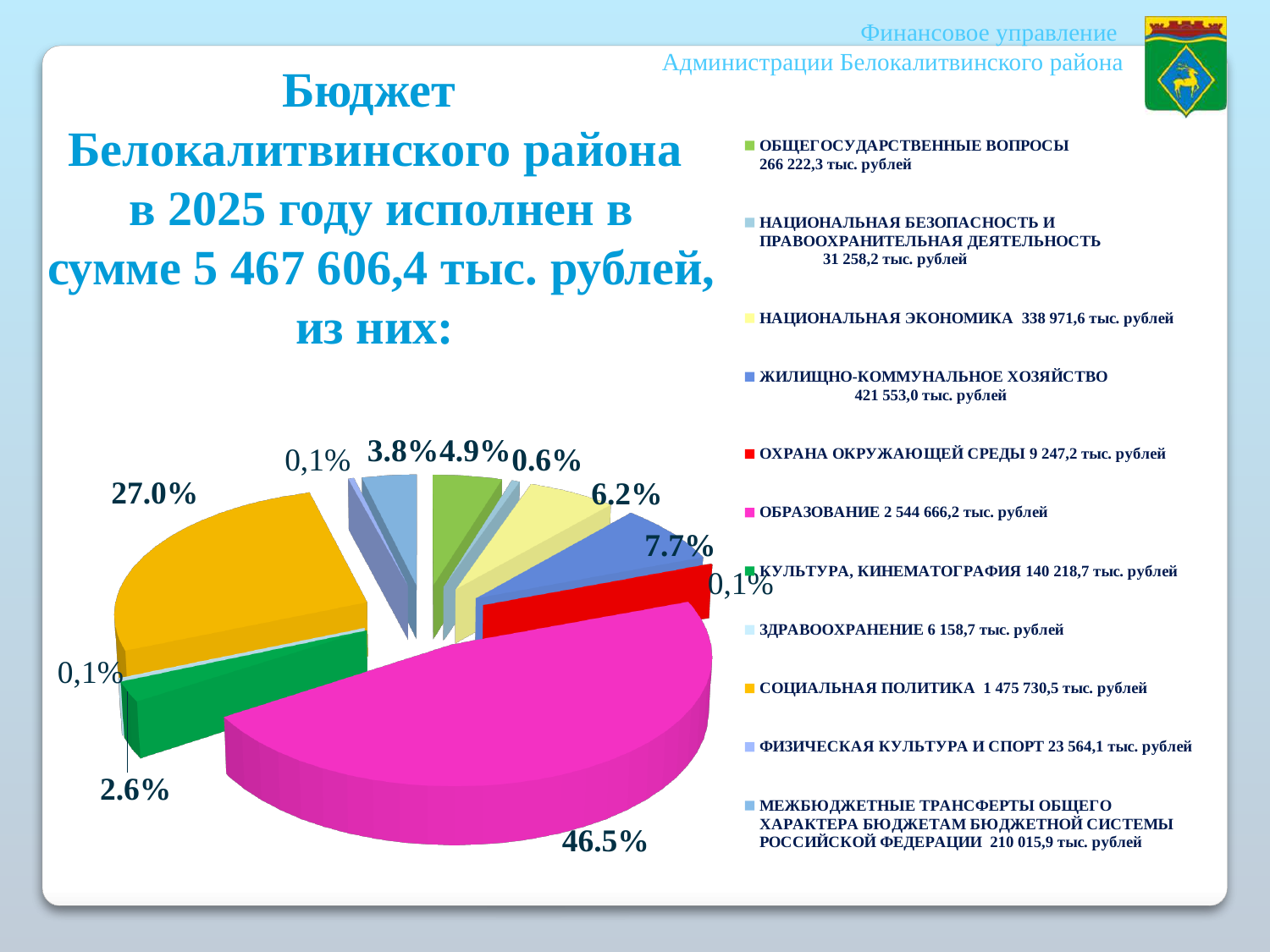
What percentage share is labelled for the СОЦИАЛЬНАЯ ПОЛИТИКА slice? 27.0% Which is larger, the value for ОБРАЗОВАНИЕ or the value for СОЦИАЛЬНАЯ ПОЛИТИКА? ОБРАЗОВАНИЕ What value is given in the legend for ЖИЛИЩНО-КОММУНАЛЬНОЕ ХОЗЯЙСТВО? 421 553,0 тыс. рублей What percentage share of the pie is labelled for the largest (magenta) slice, ОБРАЗОВАНИЕ? 46.5% What is the difference between the legend values for ЖИЛИЩНО-КОММУНАЛЬНОЕ ХОЗЯЙСТВО and НАЦИОНАЛЬНАЯ ЭКОНОМИКА? 82 581,4 тыс. рублей What value is given in the legend for СОЦИАЛЬНАЯ ПОЛИТИКА? 1 475 730,5 тыс. рублей What kind of chart is shown on the slide? pie chart Which category has the largest share of the pie? ОБРАЗОВАНИЕ What value is given in the legend for ОБРАЗОВАНИЕ? 2 544 666,2 тыс. рублей Which category has the smallest value according to the legend? ЗДРАВООХРАНЕНИЕ What value is given in the legend for ОХРАНА ОКРУЖАЮЩЕЙ СРЕДЫ? 9 247,2 тыс. рублей How many categories does the legend of the pie chart list? 11